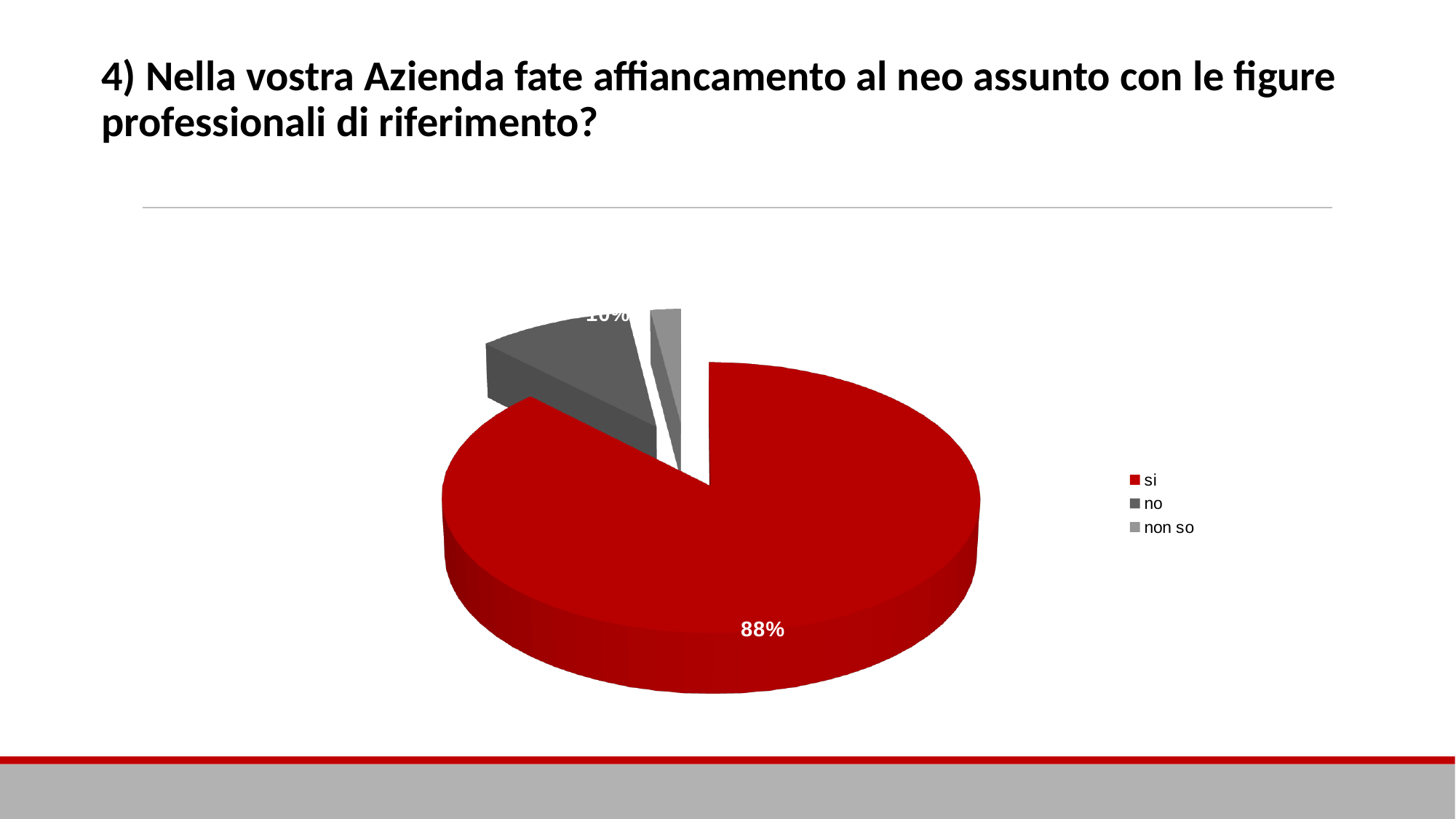
Which category has the smallest slice in the pie chart? non so Which slice is larger, "no" or "non so"? no Which category has the largest slice in the pie chart? si How many categories does the pie chart show? 3 How many entries does the legend list? 3 What are the three legend entries of the pie chart? si, no, non so What kind of chart is shown on the slide? pie chart What share of the pie does the "si" slice represent? 88% Which slice is larger, "si" or "no"? si What colour is the "si" slice in the pie chart? red What percentage of the pie chart is labelled for the "si" slice? 88%